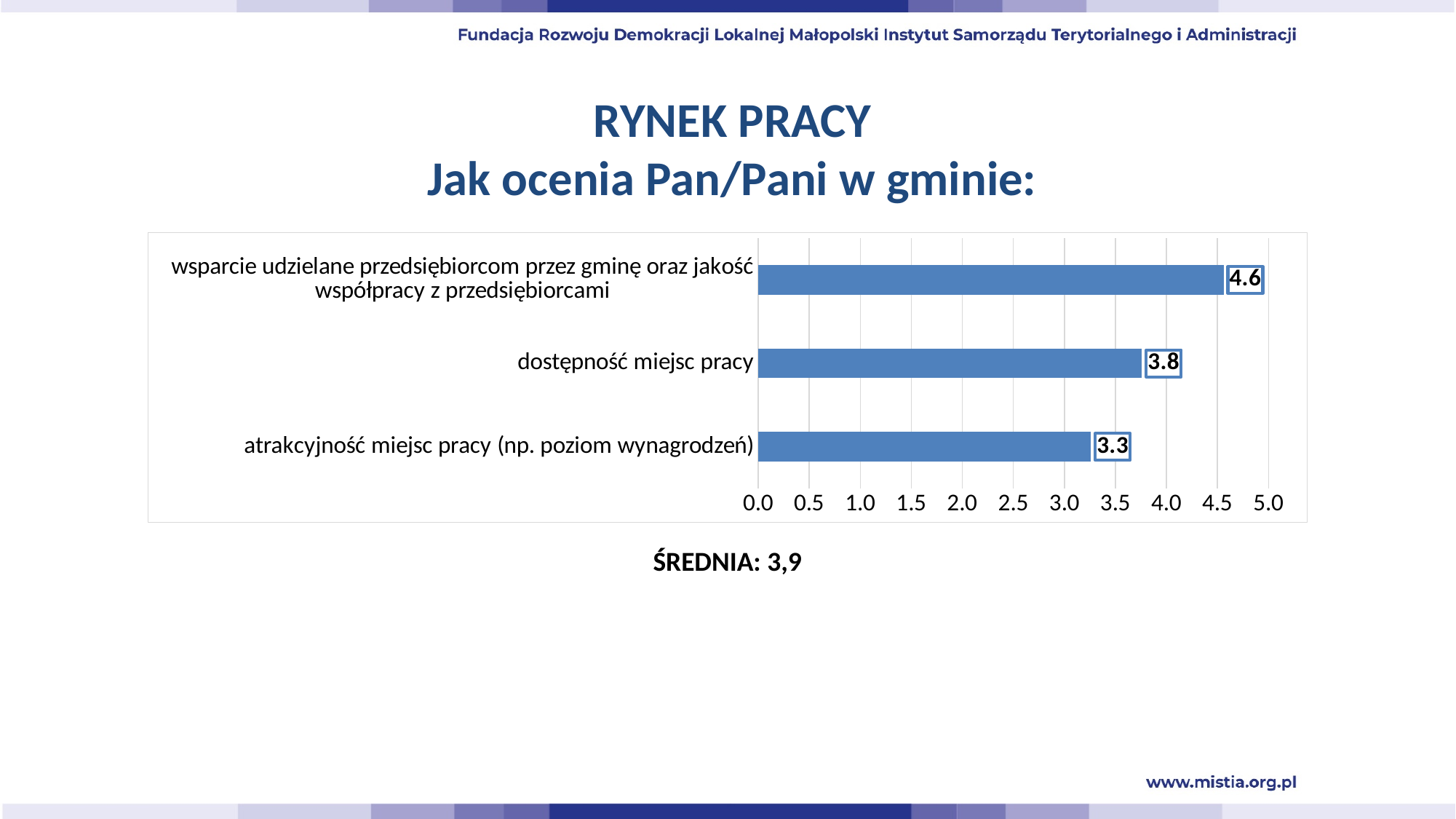
What is the value for "dostępność miejsc pracy"? 3.8 Is the value for "dostępność miejsc pracy" greater or less than 4.0? less What is the difference between the highest and lowest values in the chart? 1.3 What average (ŚREDNIA) is stated below the chart? 3,9 What is the value for "atrakcyjność miejsc pracy (np. poziom wynagrodzeń)"? 3.3 How many categories are shown in the chart? 3 Which category has the highest value? wsparcie udzielane przedsiębiorcom przez gminę oraz jakość współpracy z przedsiębiorcami What is the value for "wsparcie udzielane przedsiębiorcom przez gminę oraz jakość współpracy z przedsiębiorcami"? 4.6 Which category has the lowest value? atrakcyjność miejsc pracy (np. poziom wynagrodzeń) Which is larger: the value for "dostępność miejsc pracy" or for "atrakcyjność miejsc pracy (np. poziom wynagrodzeń)"? dostępność miejsc pracy What is the difference between the values for "dostępność miejsc pracy" and "atrakcyjność miejsc pracy (np. poziom wynagrodzeń)"? 0.5 What kind of chart is shown on the slide? bar chart